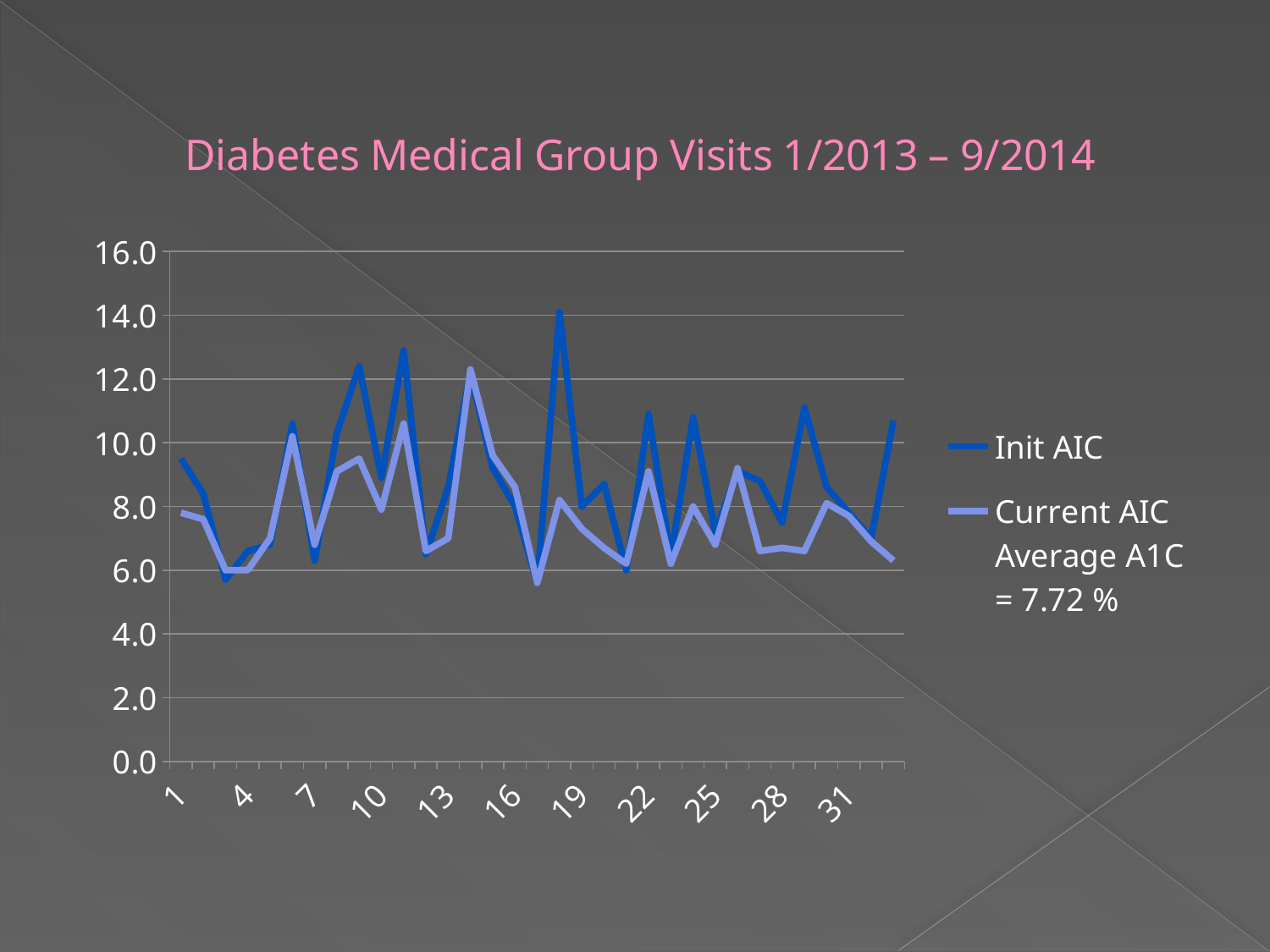
Which series reaches the highest value anywhere on the chart, Init AIC or Current AIC? Init AIC Is the highest value of the Current AIC series greater or less than 10.0? greater What is the highest value shown on the vertical axis? 16.0 What average A1C value is stated in the legend for the Current AIC series? 7.72 % At point 1, which series has the higher value, Init AIC or Current AIC? Init AIC What is the title of the chart? Diabetes Medical Group Visits 1/2013 – 9/2014 Is the value of Init AIC at point 1 greater or less than 10.0? less Is the value of Init AIC at point 1 greater or less than 8.0? greater What kind of chart is shown on the slide? line chart How many series does the legend list? 2